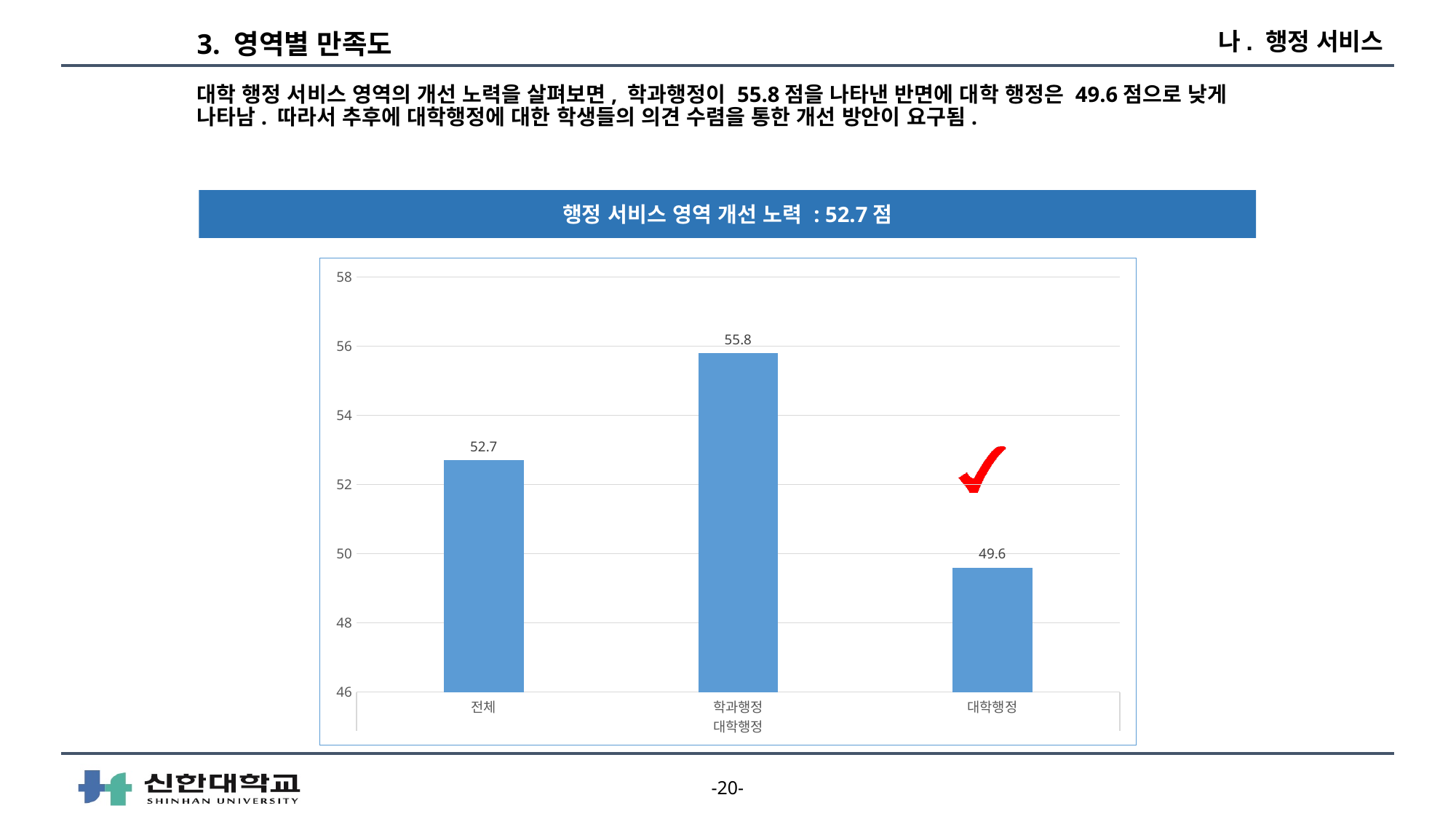
What is the difference between the values for 전체 and 대학행정? 3.1 Which is larger, the value for 전체 or the value for 대학행정? 전체 What is the value for 대학행정? 49.6 What is the difference between the values for 학과행정 and 대학행정? 6.2 What is the value for 전체? 52.7 How many bars are shown in the chart? 3 Which category has the lowest value? 대학행정 Which category has the highest value? 학과행정 What is the value for 학과행정? 55.8 Is the value for 대학행정 greater or less than 50? less What is the title shown in the blue banner above the chart? 행정 서비스 영역 개선 노력 : 52.7 점 What kind of chart is shown on the slide? bar chart